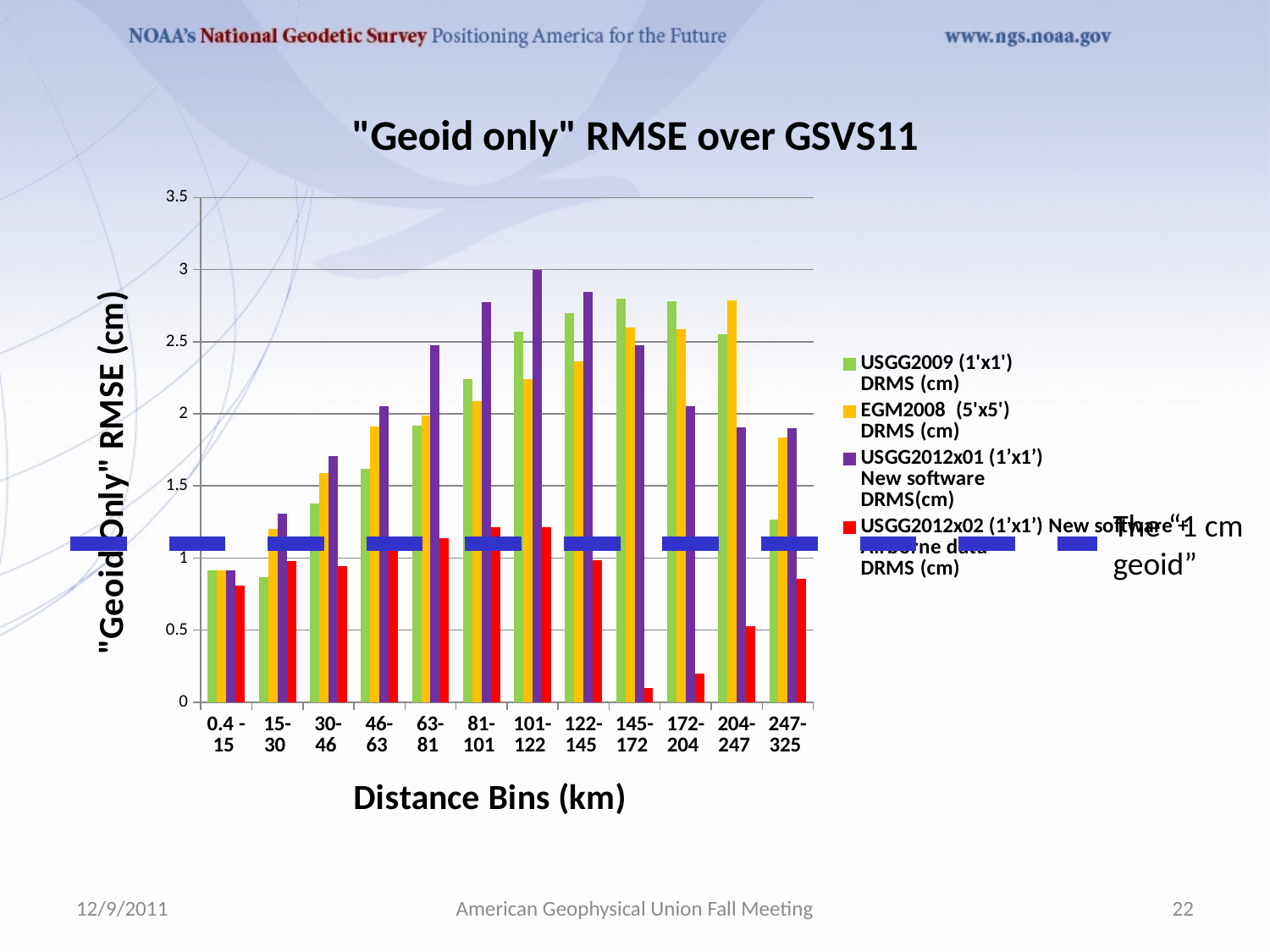
Is the USGG2012x01 (1'x1') New software value for the 101-122 bin greater or less than 2.5? greater Which distance bin has the highest value for the USGG2012x01 (1'x1') New software series? 101-122 How many distance bins are shown on the x axis of the chart? 12 Do the USGG2012x01 (1'x1') New software values rise or fall from the 0.4-15 bin to the 101-122 bin? rise How many series does the chart's legend list? 4 Which distance bin has the lowest value for the USGG2012x02 (1'x1') New software + Airborne data series? 145-172 In the 204-247 bin, which is larger: the EGM2008 (5'x5') value or the USGG2012x01 (1'x1') New software value? EGM2008 (5'x5') What kind of chart is shown on the slide? bar chart In the 63-81 bin, which is larger: the EGM2008 (5'x5') value or the USGG2012x01 (1'x1') New software value? USGG2012x01 (1'x1') New software What is the title of the chart's x axis? Distance Bins (km) Is the USGG2009 (1'x1') value for the 15-30 bin greater or less than 1? less Is the USGG2012x02 (1'x1') New software + Airborne data value for the 145-172 bin greater or less than 0.5? less